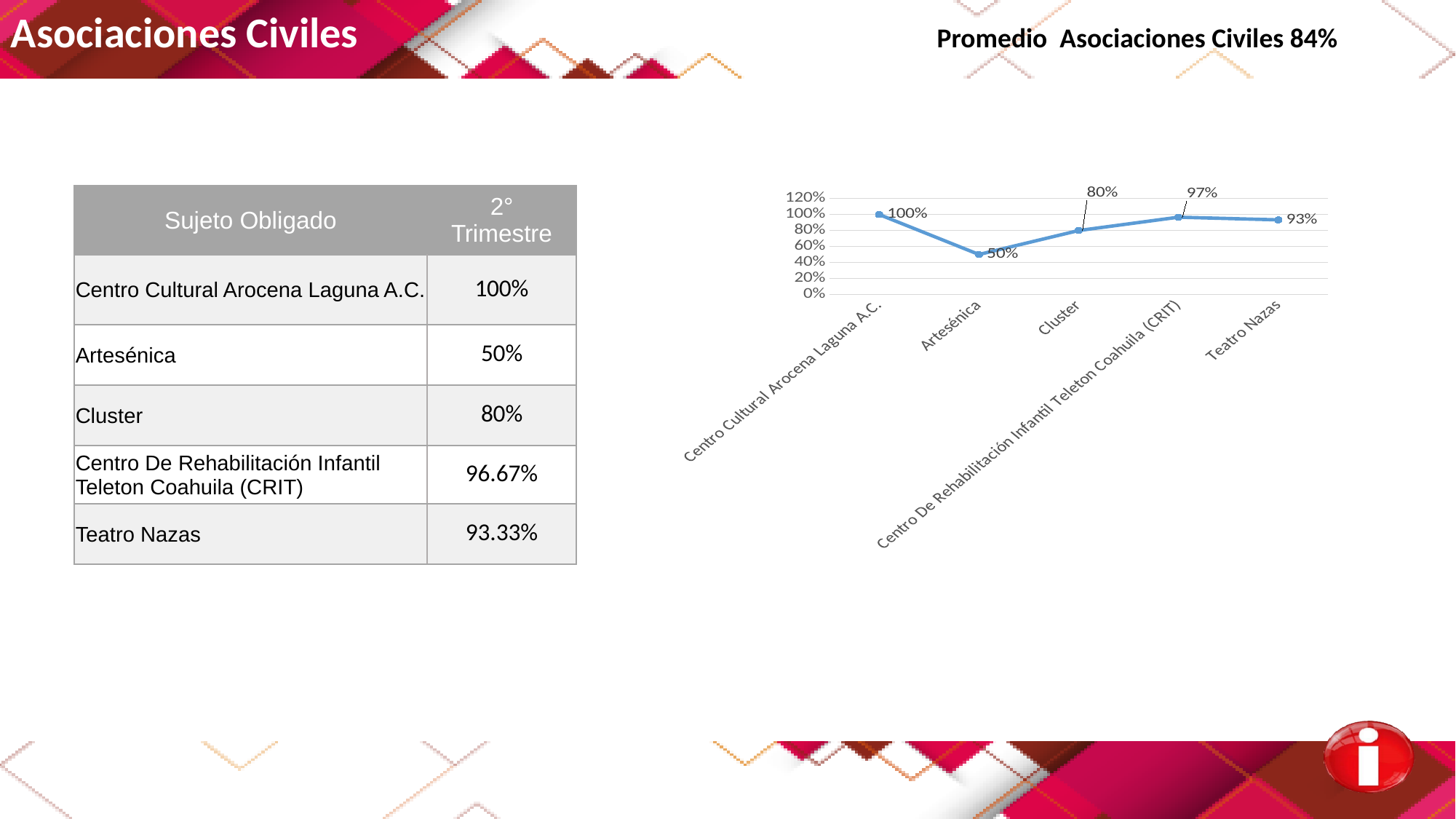
Is the value for Artesénica greater or less than 60%? less Which has a larger value on the chart, Cluster or Teatro Nazas? Teatro Nazas What is the value shown for Artesénica on the chart? 50% Which category has the lowest value on the chart? Artesénica What is the value shown for Teatro Nazas on the chart? 93% Which category has the highest value on the chart? Centro Cultural Arocena Laguna A.C. How many data points are plotted on the line chart? 5 What is the value shown for Centro De Rehabilitación Infantil Teleton Coahuila (CRIT) on the chart? 97% What type of chart is shown on the slide? line chart What is the value shown for Cluster on the chart? 80% What is the highest tick value shown on the chart's vertical axis? 120% What is the difference between the chart values for Centro Cultural Arocena Laguna A.C. and Artesénica? 50%